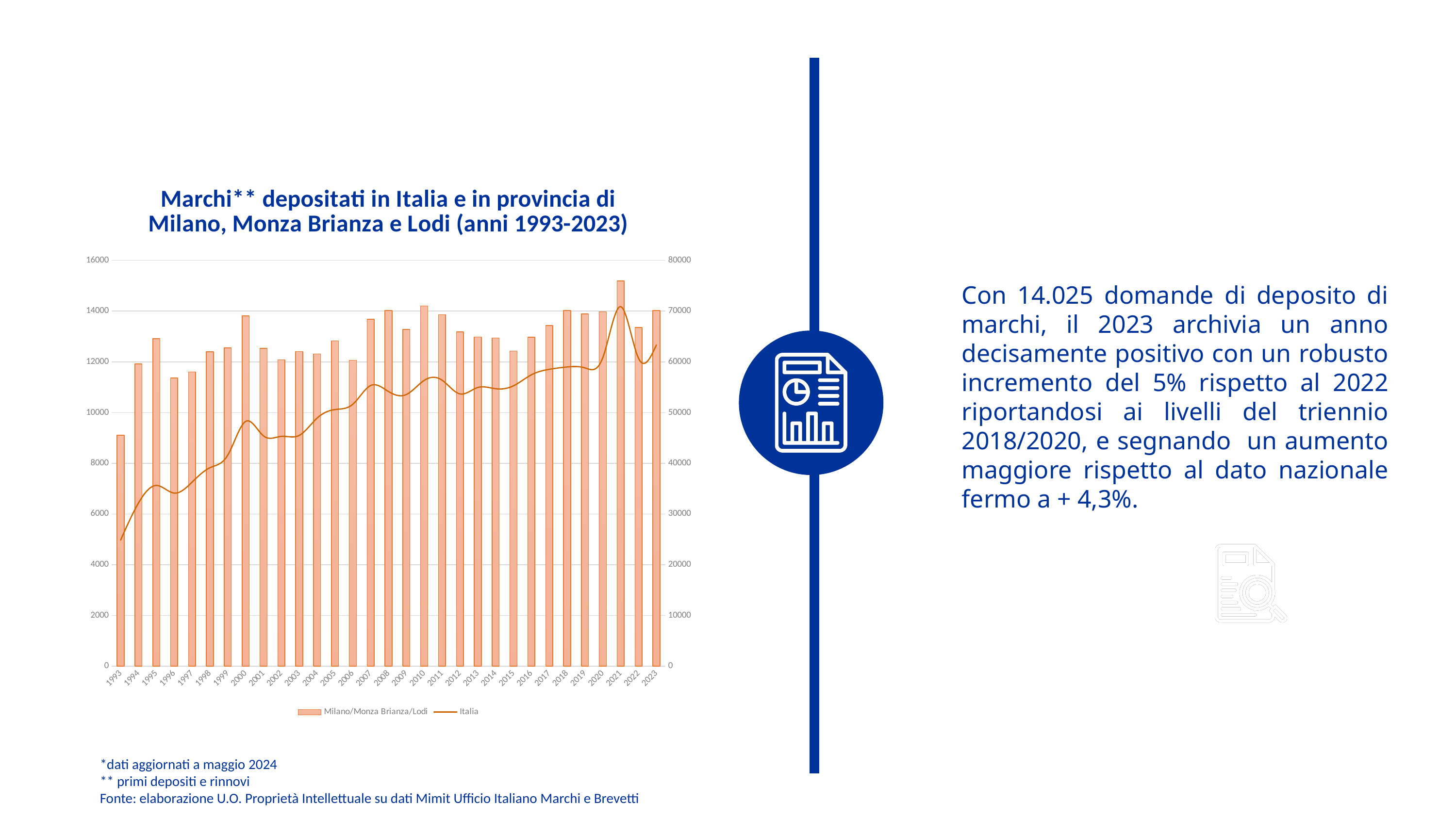
Is the Italia value for 1993 greater or less than 30000? less What kind of chart is shown on the slide? A combined bar and line chart How many years are shown on the x axis? 31 Which year has the highest bar for Milano/Monza Brianza/Lodi? 2021 Which is larger for Milano/Monza Brianza/Lodi, the bar for 1995 or the bar for 1996? 1995 How many series does the legend list? 2 Is the Milano/Monza Brianza/Lodi value for 1993 greater or less than 10000? less Which year has the lowest bar for Milano/Monza Brianza/Lodi? 1993 Does the Italia line generally rise or fall from 1993 to 2023? rise Is the Italia value for 2023 greater or less than 60000? greater Which series is drawn as a line in the chart? Italia